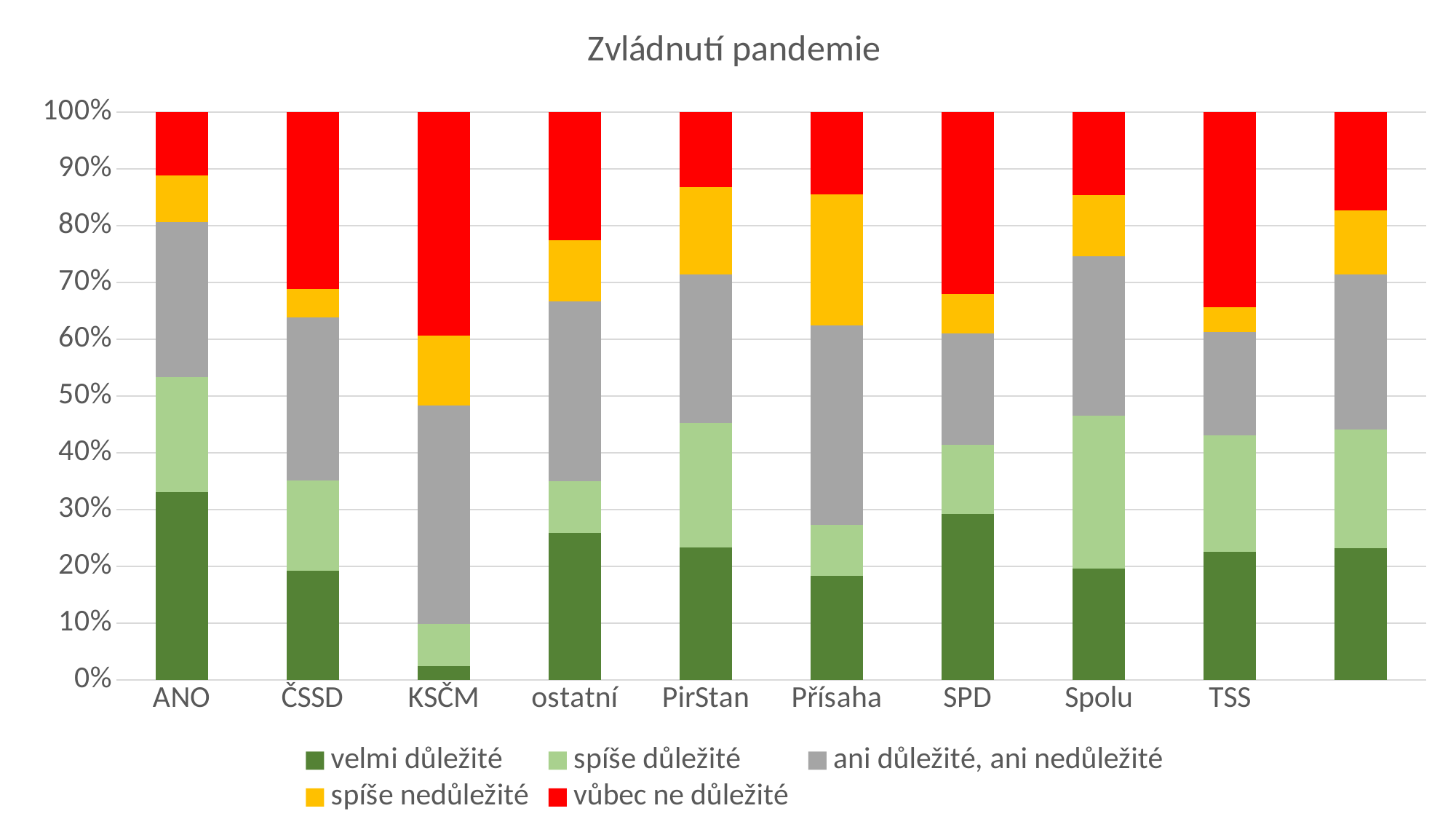
Is the 'velmi důležité' value for KSČM greater or less than 10%? less Which category has the largest 'velmi důležité' segment? ANO Is the 'velmi důležité' value for ANO greater or less than 30%? greater Is the 'velmi důležité' value for Přísaha greater or less than 20%? less What kind of chart is shown on the slide? stacked bar chart What is the title of the chart? Zvládnutí pandemie Which has a larger 'vůbec ne důležité' segment, ČSSD or ANO? ČSSD Which category has the largest 'vůbec ne důležité' segment? KSČM How many series does the legend list? 5 Which category has the smallest 'velmi důležité' segment? KSČM How many bars are plotted in the chart? 10 Which colour represents 'spíše nedůležité' in the legend? yellow